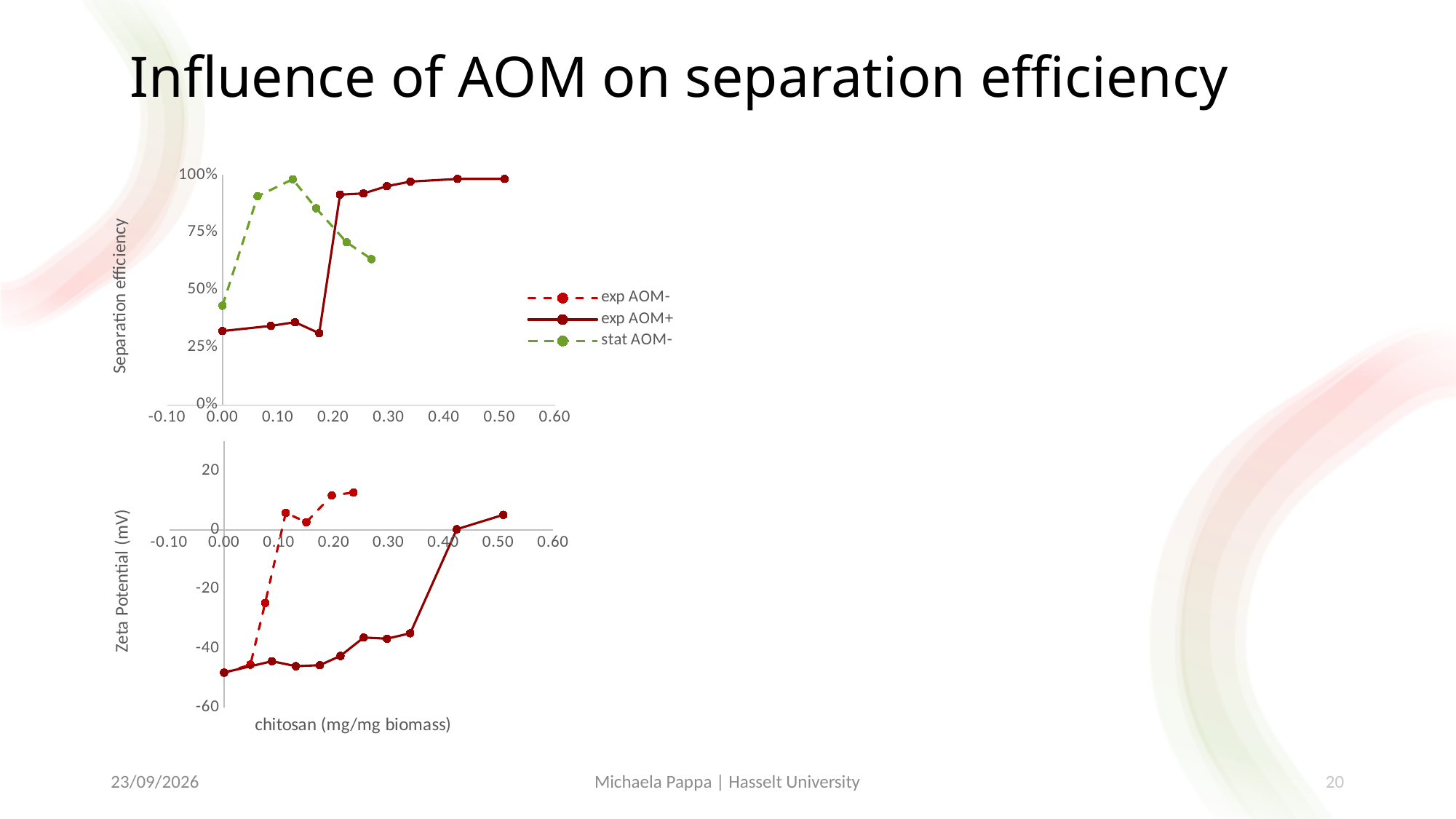
In the top chart (Separation efficiency), is the value for stat AOM- at chitosan 0.00 greater or less than 50%? less In the top chart (Separation efficiency), how many data points are plotted for stat AOM-? 6 In the top chart (Separation efficiency), does the exp AOM+ series overall rise or fall as chitosan increases? rise How many series does the legend list? 3 In the bottom chart (Zeta Potential), is the value for exp AOM+ at chitosan 0.00 greater or less than -40? less What kind of chart is the top chart (Separation efficiency)? line chart In the top chart (Separation efficiency), is the value for exp AOM+ at chitosan 0.50 greater or less than 75%? greater What is the x-axis label shown below the bottom chart? chitosan (mg/mg biomass) In the bottom chart (Zeta Potential), does the exp AOM+ series overall rise or fall as chitosan increases? rise In the top chart (Separation efficiency), at chitosan 0.00, which series has the higher value, exp AOM+ or stat AOM-? stat AOM-